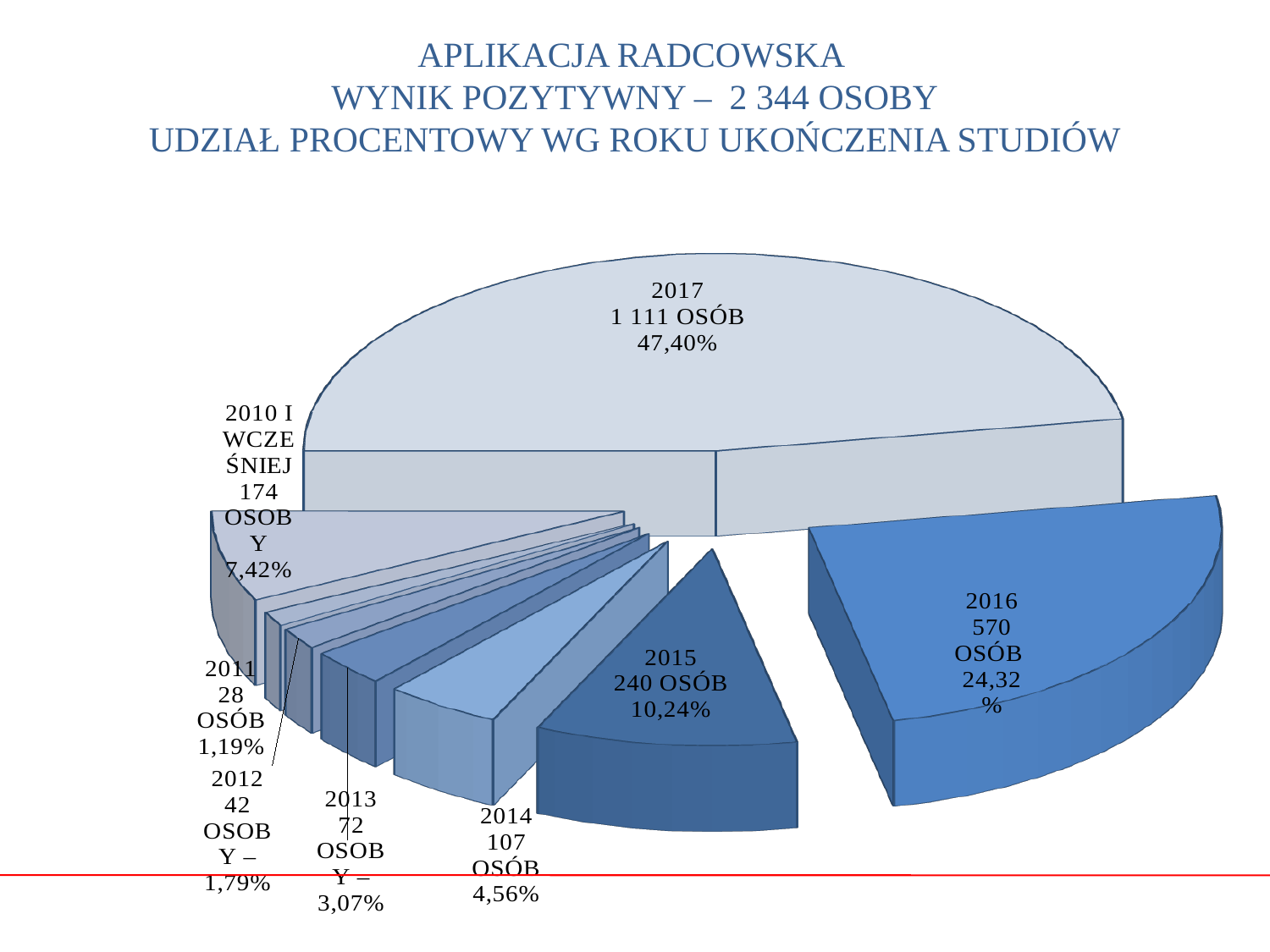
Which year has the largest slice of the pie? 2017 How many slices does the pie chart have? 8 What kind of chart is shown on the slide? pie chart How many people are shown for 2014? 107 What percentage share is shown for 2015? 10,24% What percentage share is shown for the category '2010 i wcześniej'? 7,42% What percentage share is shown for 2013? 3,07% Which category has the smallest slice of the pie? 2011 Which has more people, 2012 or 2011? 2012 How many people (osób) are shown for 2016? 570 What percentage share is shown for 2017? 47,40% What is the difference in number of people between 2017 and 2016? 541